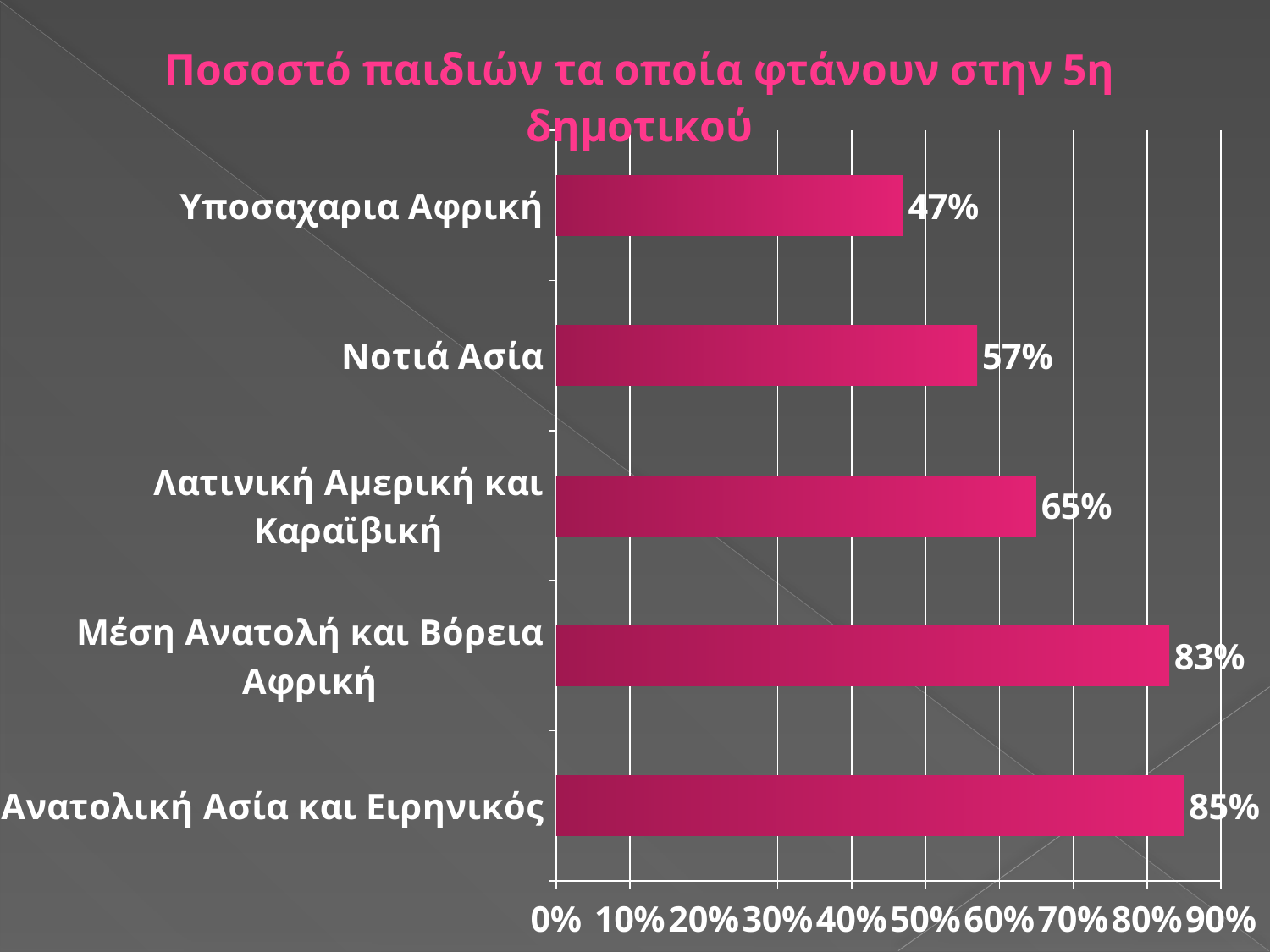
What is the value for Νοτιά Ασία? 57% Which region has the highest value? Ανατολική Ασία και Ειρηνικός Which region has the lowest value? Υποσαχαρια Αφρική How many regions are shown in the chart? 5 What is the value for Ανατολική Ασία και Ειρηνικός? 85% What is the difference between the values for Μέση Ανατολή και Βόρεια Αφρική and Υποσαχαρια Αφρική? 36% What is the value for Υποσαχαρια Αφρική? 47% What is the value for Λατινική Αμερική και Καραϊβική? 65% What is the value for Μέση Ανατολή και Βόρεια Αφρική? 83% What kind of chart is shown on the slide? Bar chart Which is larger, the value for Νοτιά Ασία or the value for Λατινική Αμερική και Καραϊβική? Λατινική Αμερική και Καραϊβική What is the title of the chart? Ποσοστό παιδιών τα οποία φτάνουν στην 5η δημοτικού